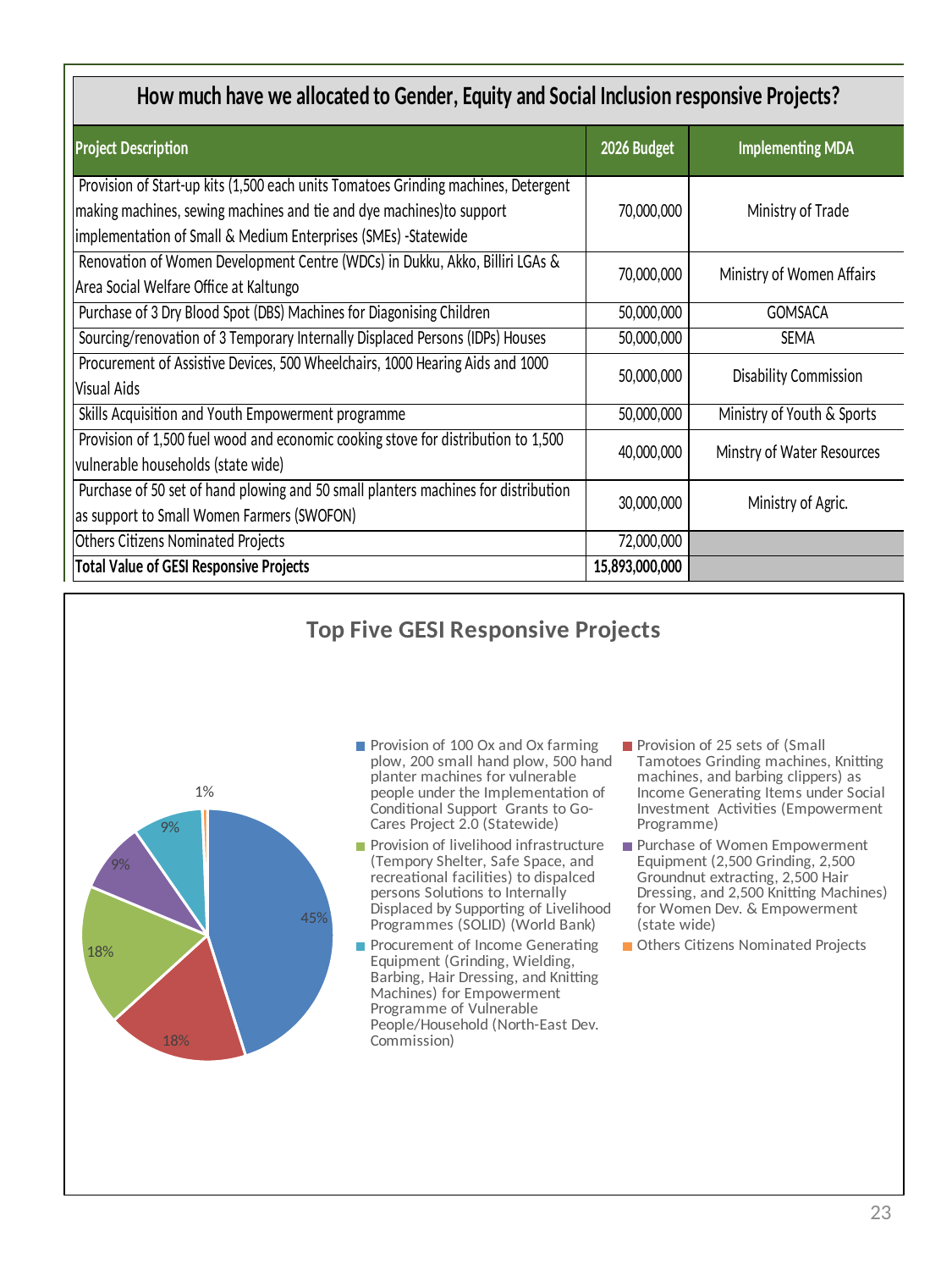
Which slice of the pie chart is the smallest? Others Citizens Nominated Projects (1%) What kind of chart is shown under the title "Top Five GESI Responsive Projects"? Pie chart In the pie chart, what share is shown for the "Purchase of Women Empowerment Equipment" project? 9% How many entries does the pie chart's legend list? 6 What is the title of the pie chart on the slide? Top Five GESI Responsive Projects In the pie chart, which is larger: the share for the "Provision of 25 sets of (Small Tamotoes Grinding machines...)" project or the share for the "Procurement of Income Generating Equipment" project? Provision of 25 sets of (Small Tamotoes Grinding machines...) (18% vs 9%) How many slices does the pie chart have? 6 In the pie chart, what share is shown for the "Provision of livelihood infrastructure" project? 18% Which slice of the pie chart is the largest? Provision of 100 Ox and Ox farming plow, 200 small hand plow, 500 hand planter machines (45%) In the pie chart, what is the difference in percentage points between the largest slice (45%) and the "Others Citizens Nominated Projects" slice (1%)? 44 percentage points In the pie chart, what share is shown for the "Provision of 100 Ox and Ox farming plow..." project? 45%